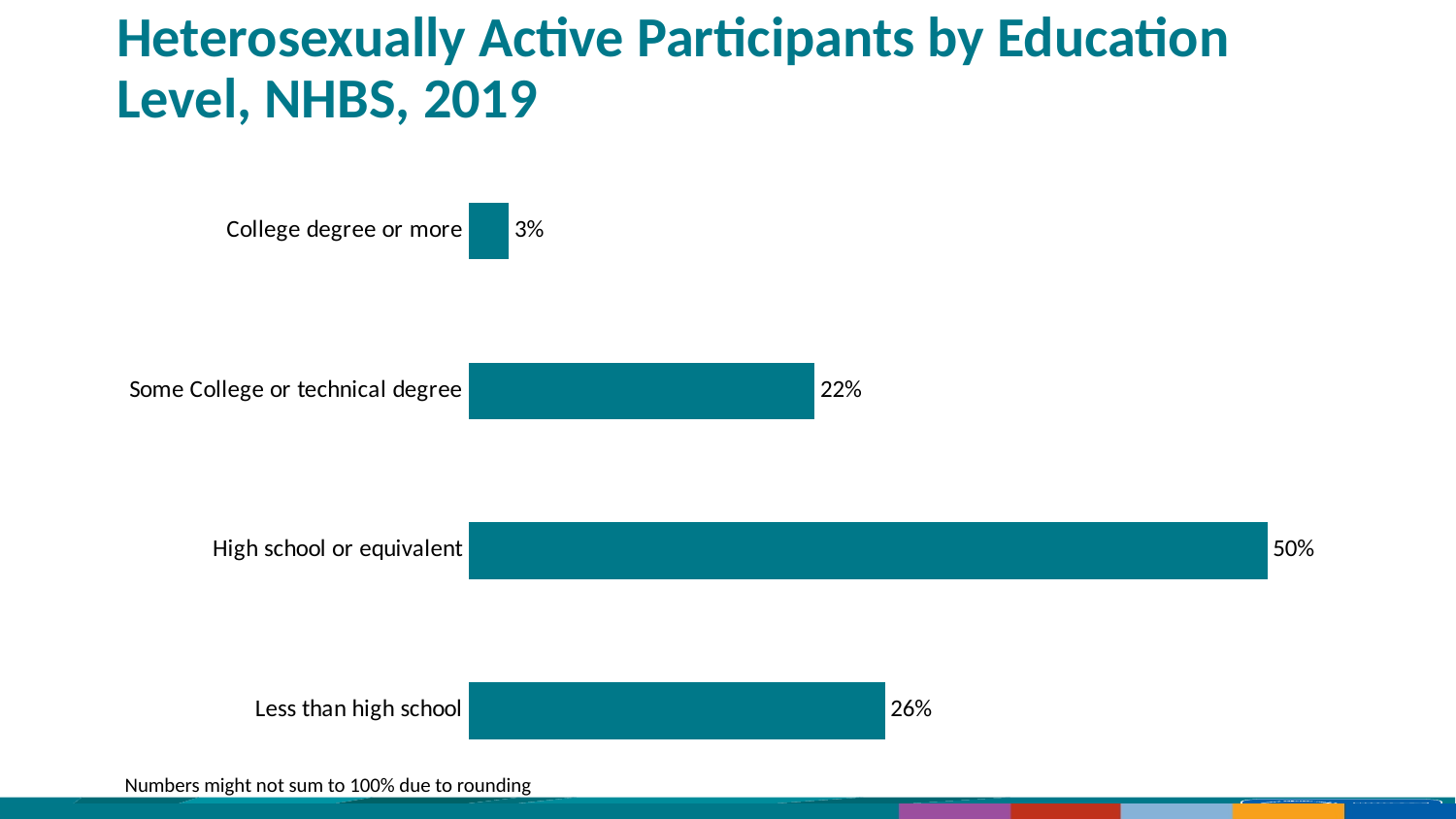
Which education level has the highest percentage of participants? High school or equivalent What is the value for Less than high school? 26% What note appears below the chart? Numbers might not sum to 100% due to rounding What kind of chart is shown on the slide? Bar chart Which education level has the lowest percentage of participants? College degree or more What is the value for Some College or technical degree? 22% What is the difference between the Some College or technical degree and College degree or more values? 19% What is the value for High school or equivalent? 50% How many education level categories are shown in the chart? 4 What is the difference between the High school or equivalent and Less than high school values? 24% Which is larger, the value for Less than high school or the value for Some College or technical degree? Less than high school What percentage of heterosexually active participants had a college degree or more? 3%